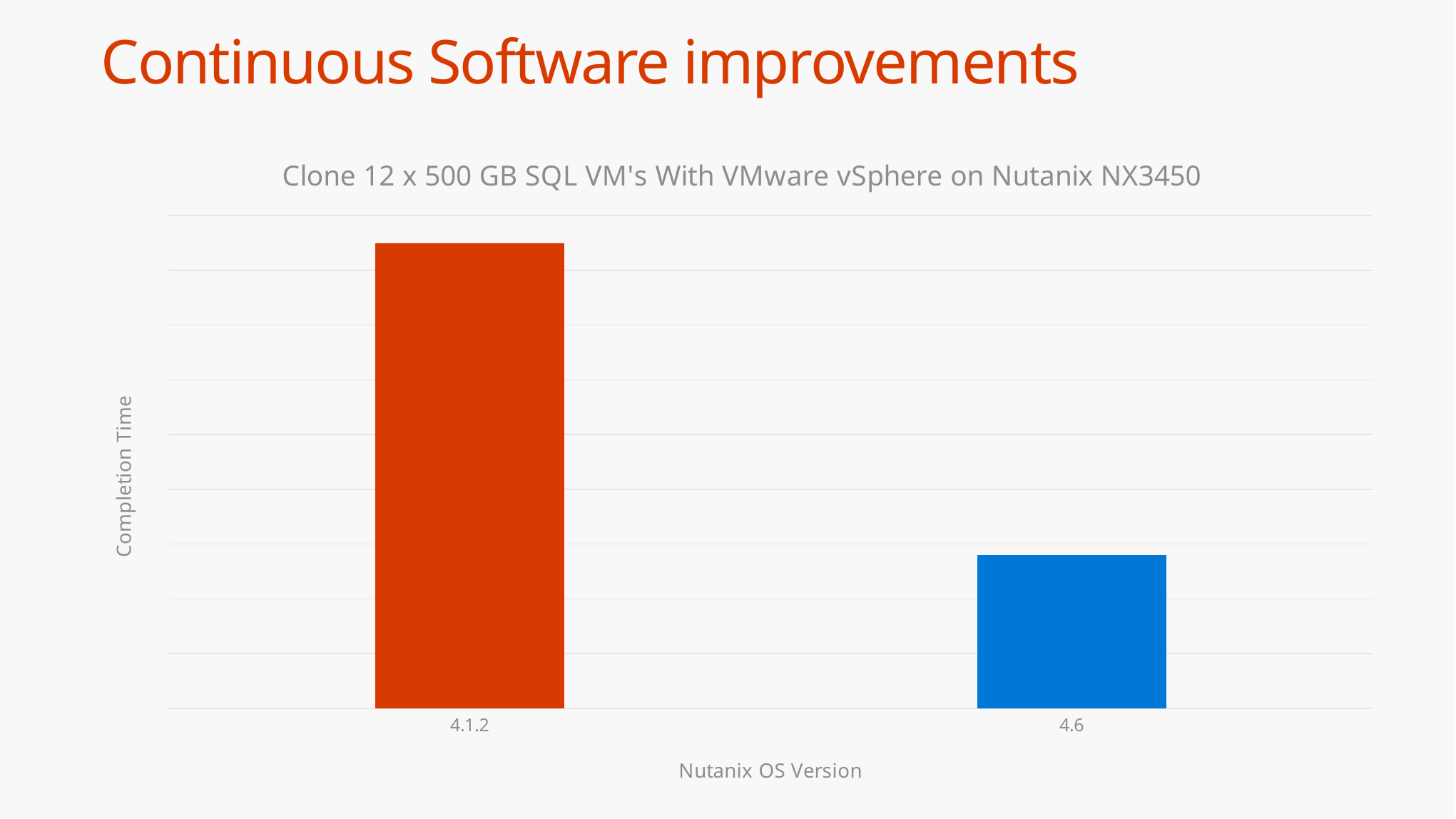
What kind of chart is shown on the slide? bar chart What is the label of the x axis of the chart? Nutanix OS Version Does the completion time rise or fall from version 4.1.2 to version 4.6? fall Which has a larger completion time, version 4.1.2 or version 4.6? 4.1.2 Which Nutanix OS version has the lowest completion time? 4.6 What is the title of the chart? Clone 12 x 500 GB SQL VM's With VMware vSphere on Nutanix NX3450 How many Nutanix OS versions are plotted on the chart? 2 Which Nutanix OS version has the highest completion time? 4.1.2